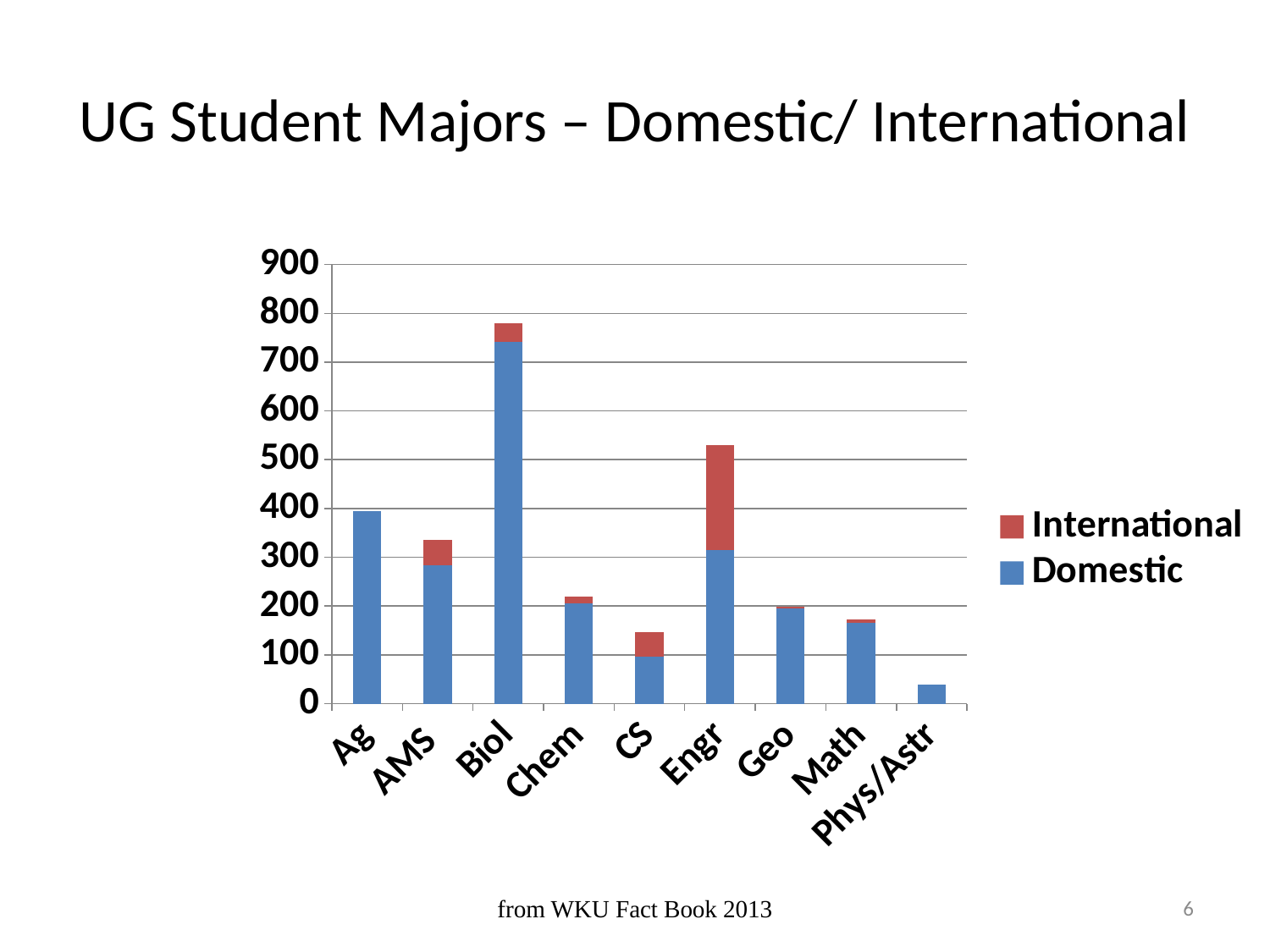
How many series does the legend list? 2 Which colour represents the Domestic series in the legend? Blue Which major has the tallest bar overall? Biol What is the title of the slide containing the chart? UG Student Majors – Domestic/ International Which major has the largest International segment? Engr Is the value for Phys/Astr greater or less than 100? less What kind of chart is shown on the slide? Stacked bar chart Which major has the shortest bar overall? Phys/Astr How many majors (categories) are shown on the x axis? 9 Is the total value for CS greater or less than 100? greater Is the total value for Biol greater or less than 700? greater Which has a taller total bar, Engr or AMS? Engr